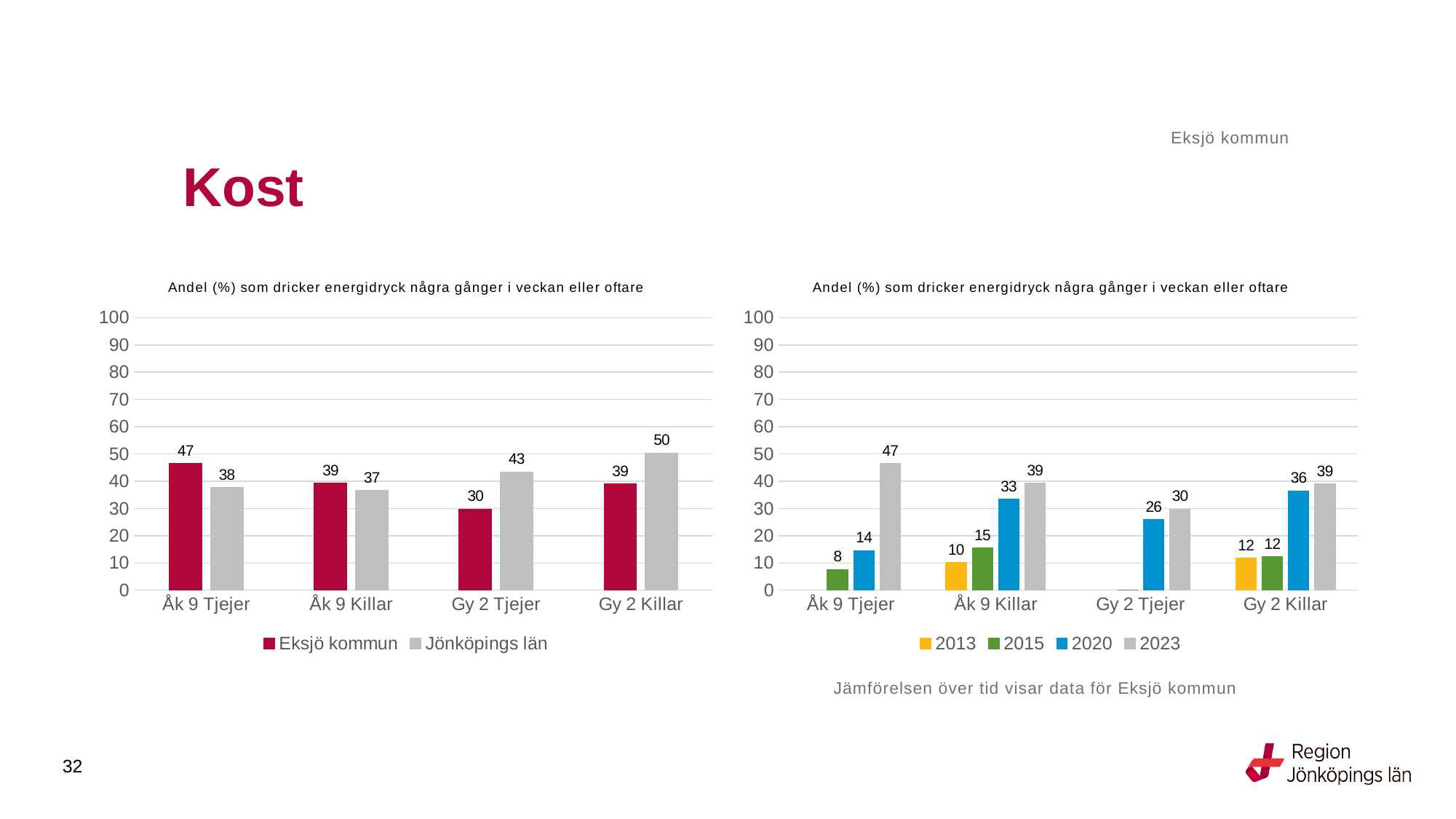
In the right chart, what is the value for 2020 for Åk 9 Killar? 33 In the right chart, what is the value for 2013 for Gy 2 Killar? 12 In the left chart, which category has the highest value for Jönköpings län? Gy 2 Killar In the right chart, how many series does the legend list? 4 In the right chart, is the 2023 value for Gy 2 Tjejer greater or less than 40? less What kind of chart is the left chart? bar chart In the right chart, what is the difference between the 2023 and 2020 values for Åk 9 Tjejer? 33 In the left chart, what is the difference between Jönköpings län and Eksjö kommun for Gy 2 Tjejer? 13 In the left chart, which is larger for Åk 9 Killar: Eksjö kommun or Jönköpings län? Eksjö kommun In the left chart, which category has the lowest value for Eksjö kommun? Gy 2 Tjejer In the left chart, what is the value for Jönköpings län for Gy 2 Killar? 50 In the left chart, what is the value for Eksjö kommun for Åk 9 Tjejer? 47